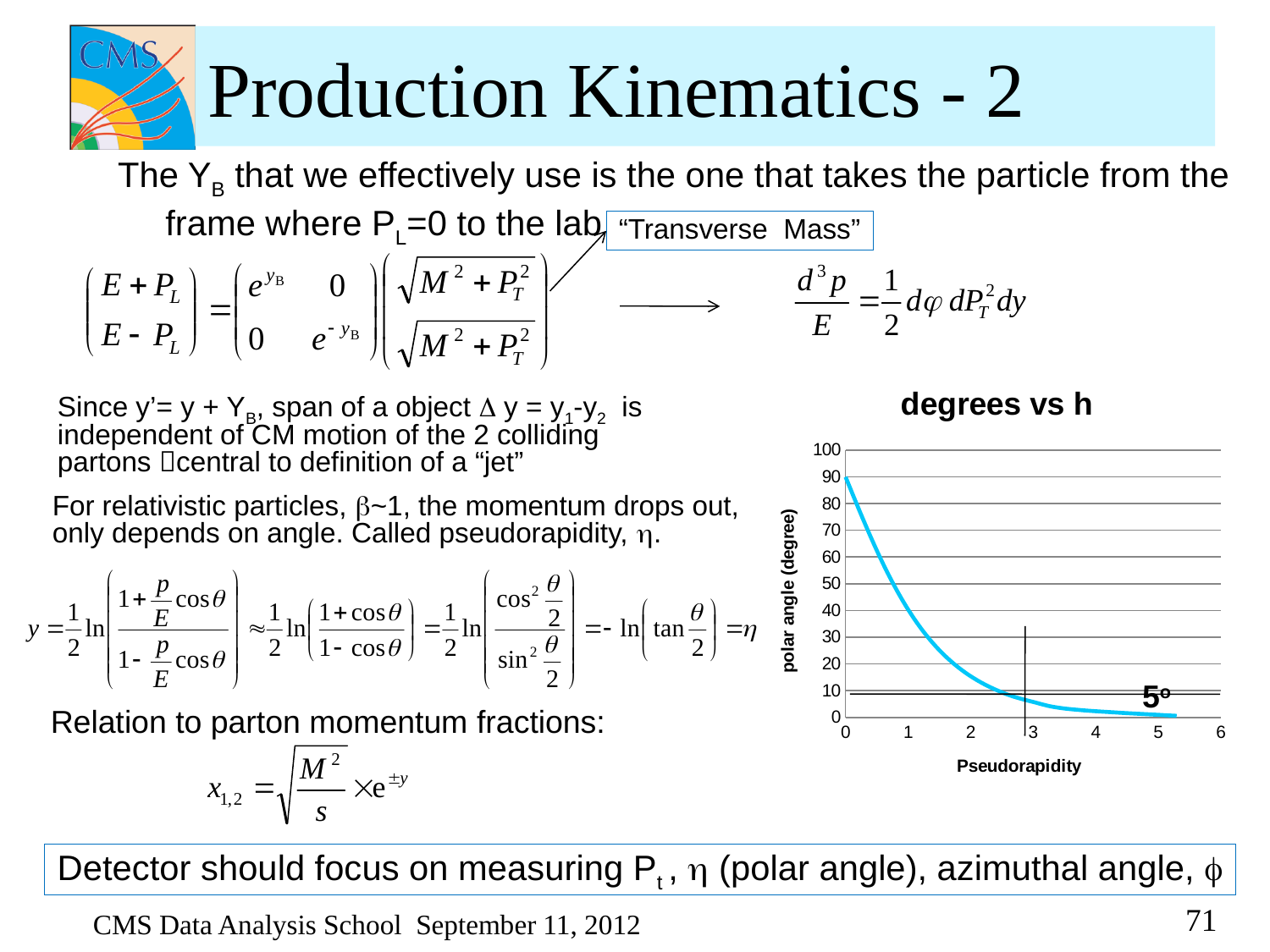
What kind of chart is the "degrees vs h" chart? line chart In the "degrees vs h" chart, is the polar angle larger at pseudorapidity 1 or at pseudorapidity 4? pseudorapidity 1 In the "degrees vs h" chart, is the polar angle at pseudorapidity 3 greater or less than 10? less In the "degrees vs h" chart, is the polar angle at pseudorapidity 5 greater or less than 10? less In the "degrees vs h" chart, do the values rise or fall as pseudorapidity increases? fall In the "degrees vs h" chart, what is the polar angle at pseudorapidity 0? 90 In the "degrees vs h" chart, is the polar angle at pseudorapidity 2 greater or less than 30? less What is the label of the x axis of the "degrees vs h" chart? Pseudorapidity What is the label of the y axis of the "degrees vs h" chart? polar angle (degree)